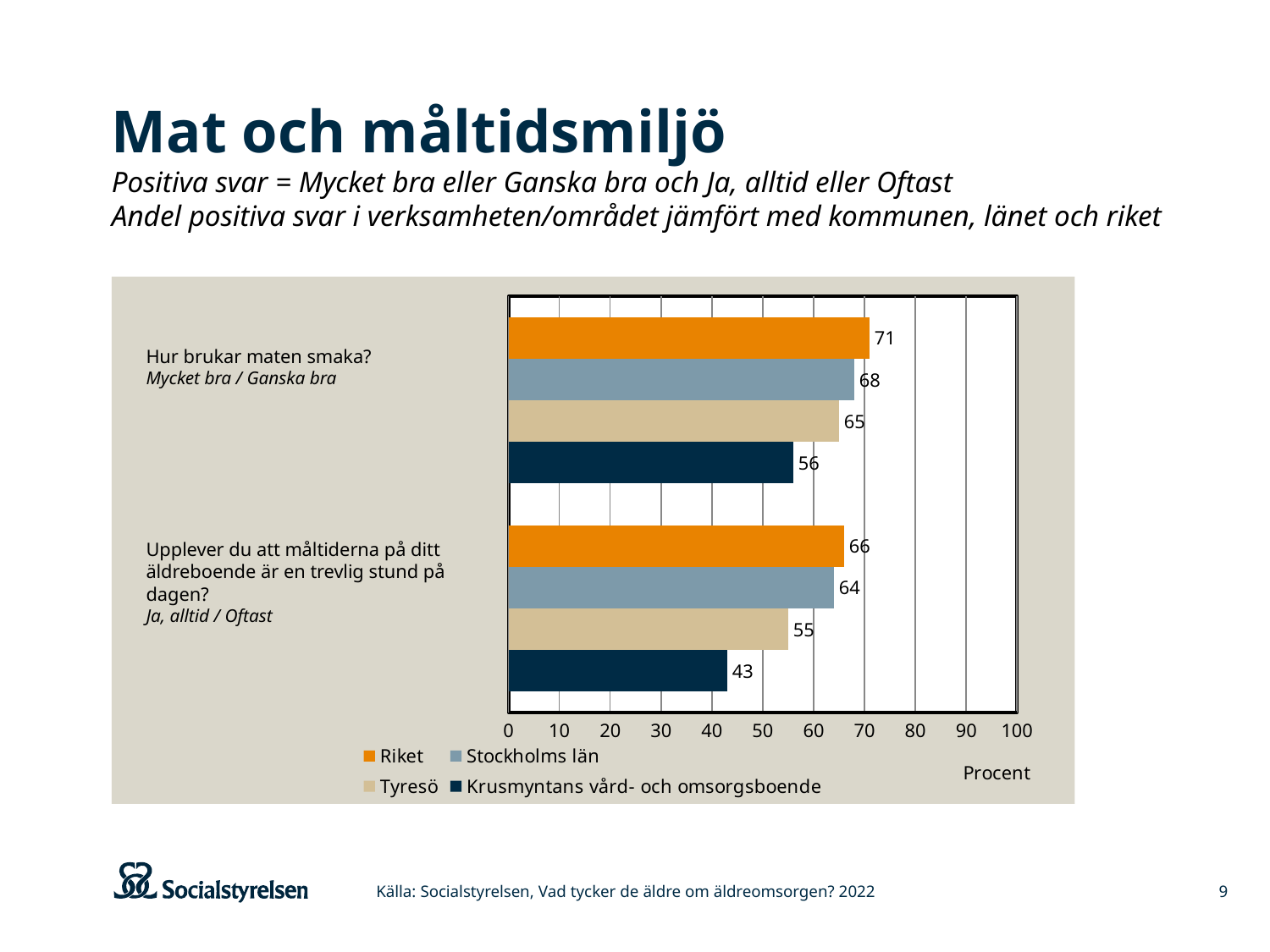
What kind of chart is shown on the slide? Bar chart What is the value for Stockholms län for "Upplever du att måltiderna på ditt äldreboende är en trevlig stund på dagen?"? 64 What is the difference between Riket and Krusmyntans vård- och omsorgsboende for "Hur brukar maten smaka?"? 15 Which series has the lowest value for "Hur brukar maten smaka?"? Krusmyntans vård- och omsorgsboende What is the value for Krusmyntans vård- och omsorgsboende for "Upplever du att måltiderna på ditt äldreboende är en trevlig stund på dagen?"? 43 What is the label on the horizontal axis of the chart? Procent Which series has the highest value for "Upplever du att måltiderna på ditt äldreboende är en trevlig stund på dagen?"? Riket What is the difference between Tyresö and Krusmyntans vård- och omsorgsboende for "Upplever du att måltiderna på ditt äldreboende är en trevlig stund på dagen?"? 12 What is the value for Tyresö for "Hur brukar maten smaka?"? 65 How many series does the legend list? 4 Which is larger: the Tyresö value for "Hur brukar maten smaka?" or the Tyresö value for "Upplever du att måltiderna på ditt äldreboende är en trevlig stund på dagen?"? Hur brukar maten smaka? What is the value for Riket for "Hur brukar maten smaka?"? 71